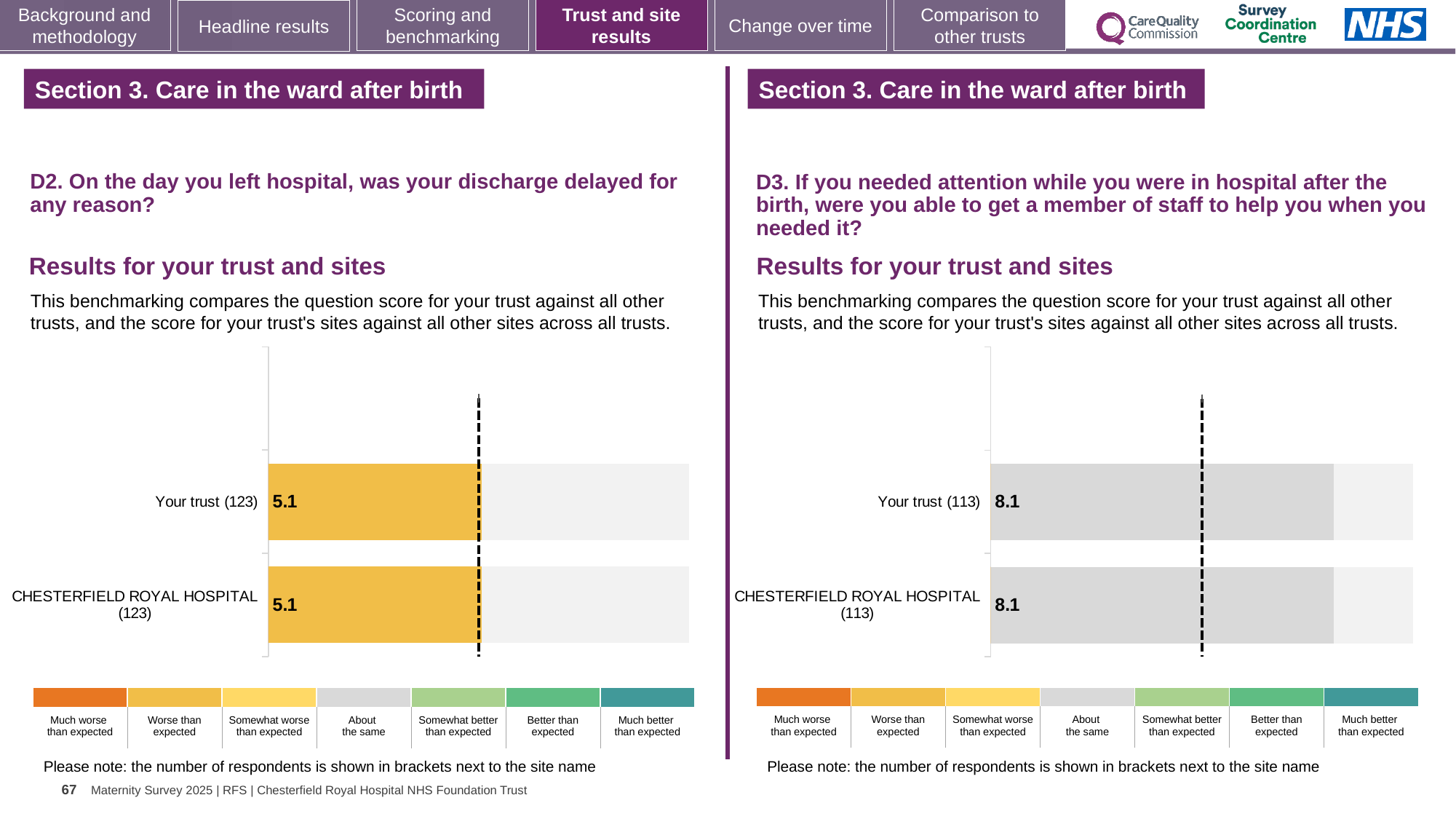
How many bars are plotted on the left chart (D2)? 2 On the right chart (D3), what is the difference between the score for Your trust and the score for CHESTERFIELD ROYAL HOSPITAL? 0 On the left chart (D2), how many respondents are shown in brackets next to Your trust? 123 On the left chart (D2, discharge delayed), what is the score for CHESTERFIELD ROYAL HOSPITAL? 5.1 What kind of chart is used on the left (D2) to show the results for your trust and sites? Bar chart On the right chart (D3, able to get a member of staff to help), what is the score for Your trust? 8.1 Is the score for Your trust on the right chart (D3) larger or smaller than the score for Your trust on the left chart (D2)? Larger On the right chart (D3, able to get a member of staff to help), what is the score for CHESTERFIELD ROYAL HOSPITAL? 8.1 On the left chart (D2), what is the difference between the score for Your trust and the score for CHESTERFIELD ROYAL HOSPITAL? 0 On the left chart (D2, discharge delayed), what is the score for Your trust? 5.1 How many bars are plotted on the right chart (D3)? 2 On the right chart (D3), how many respondents are shown in brackets next to CHESTERFIELD ROYAL HOSPITAL? 113